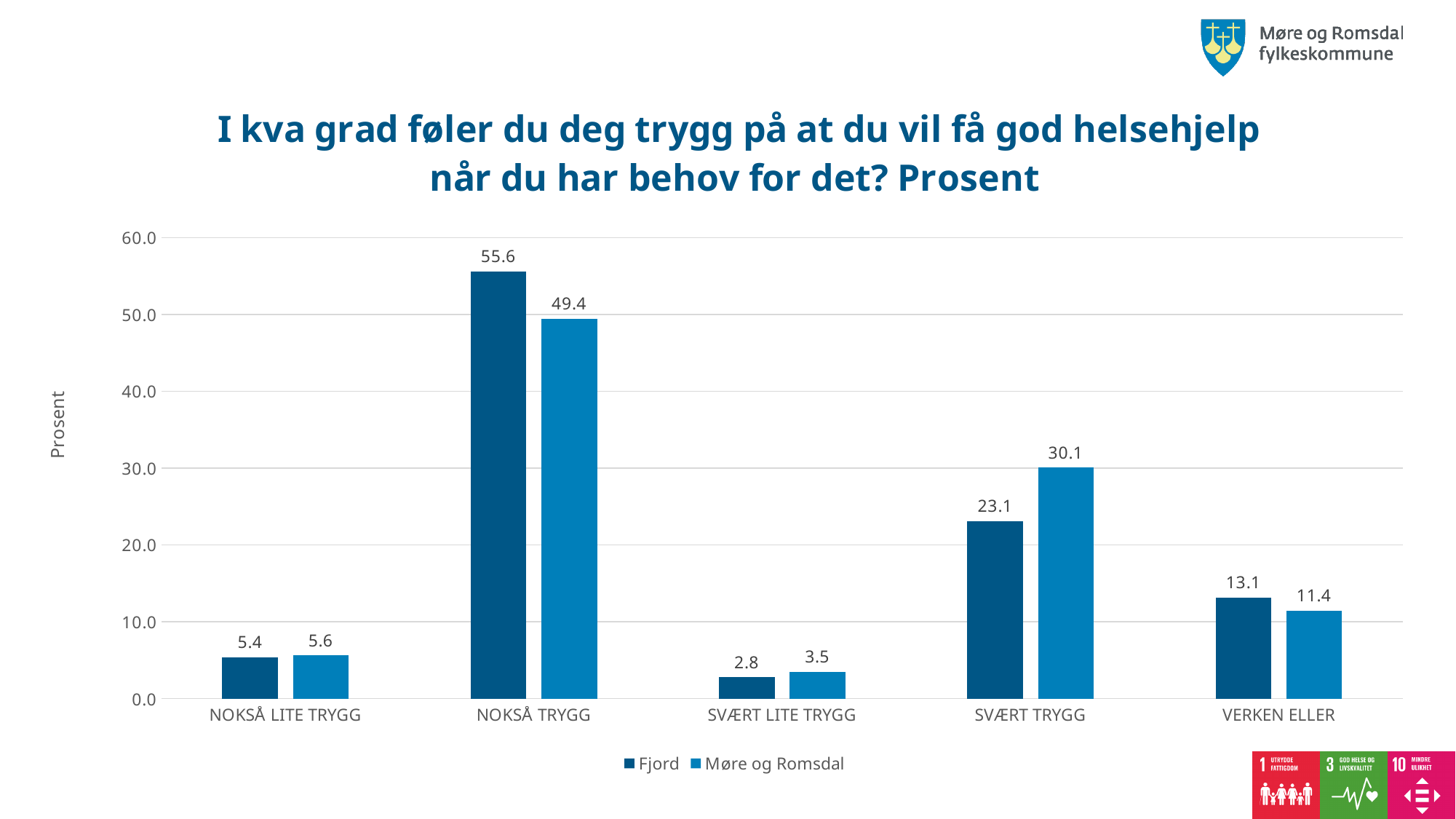
What is the value for Møre og Romsdal in the SVÆRT TRYGG category? 30.1 How many series does the legend list? 2 Which is larger in the VERKEN ELLER category, Fjord or Møre og Romsdal? Fjord What is the difference between Fjord and Møre og Romsdal in the NOKSÅ TRYGG category? 6.2 Which category has the highest value for Møre og Romsdal? NOKSÅ TRYGG Is the value for Fjord in the NOKSÅ TRYGG category greater or less than 50.0? greater What is the value for Fjord in the NOKSÅ TRYGG category? 55.6 Which category has the lowest value for Fjord? SVÆRT LITE TRYGG How many categories are shown on the x axis? 5 What kind of chart is shown on the slide? Bar chart What is the difference between Møre og Romsdal and Fjord in the SVÆRT TRYGG category? 7.0 What is the value for Fjord in the VERKEN ELLER category? 13.1